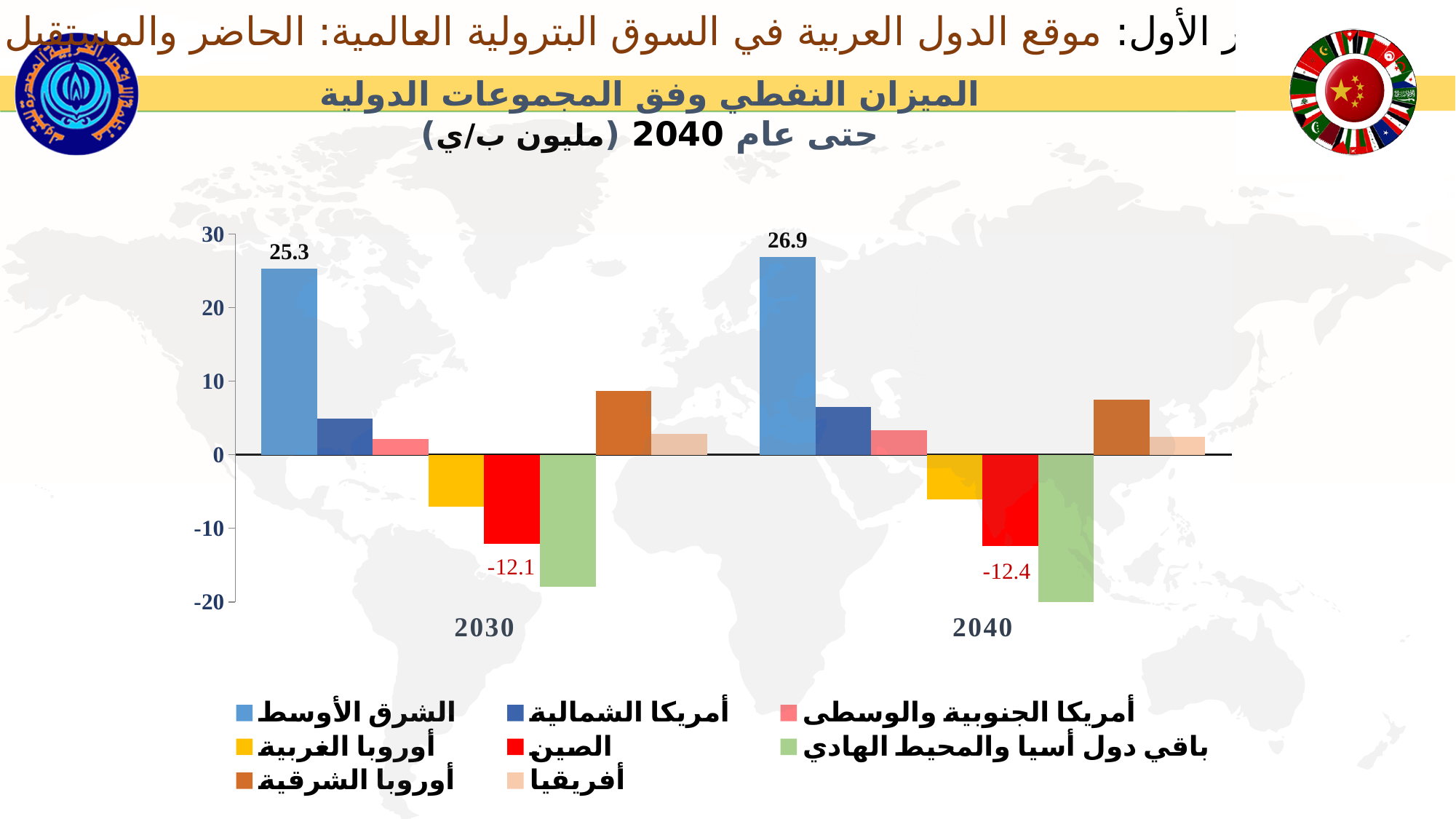
Which is larger, the Middle East value in 2030 or in 2040? 2040 (26.9) What is the value for الشرق الأوسط (Middle East) in 2030? 25.3 How many year categories are shown on the x axis? 2 What kind of chart is shown on the slide? bar chart What is the value for الصين (China) in 2030? -12.1 What is the value for الشرق الأوسط (Middle East) in 2040? 26.9 Is the value for أوروبا الشرقية (Eastern Europe) in 2030 greater or less than 10? less What is the value for الصين (China) in 2040? -12.4 Which series has the highest value in the chart? الشرق الأوسط (Middle East) By how much does the Middle East value increase from 2030 to 2040? 1.6 Which series has the lowest value in 2040? باقي دول آسيا والمحيط الهادي (Rest of Asia and Pacific) How many series does the legend list? 8